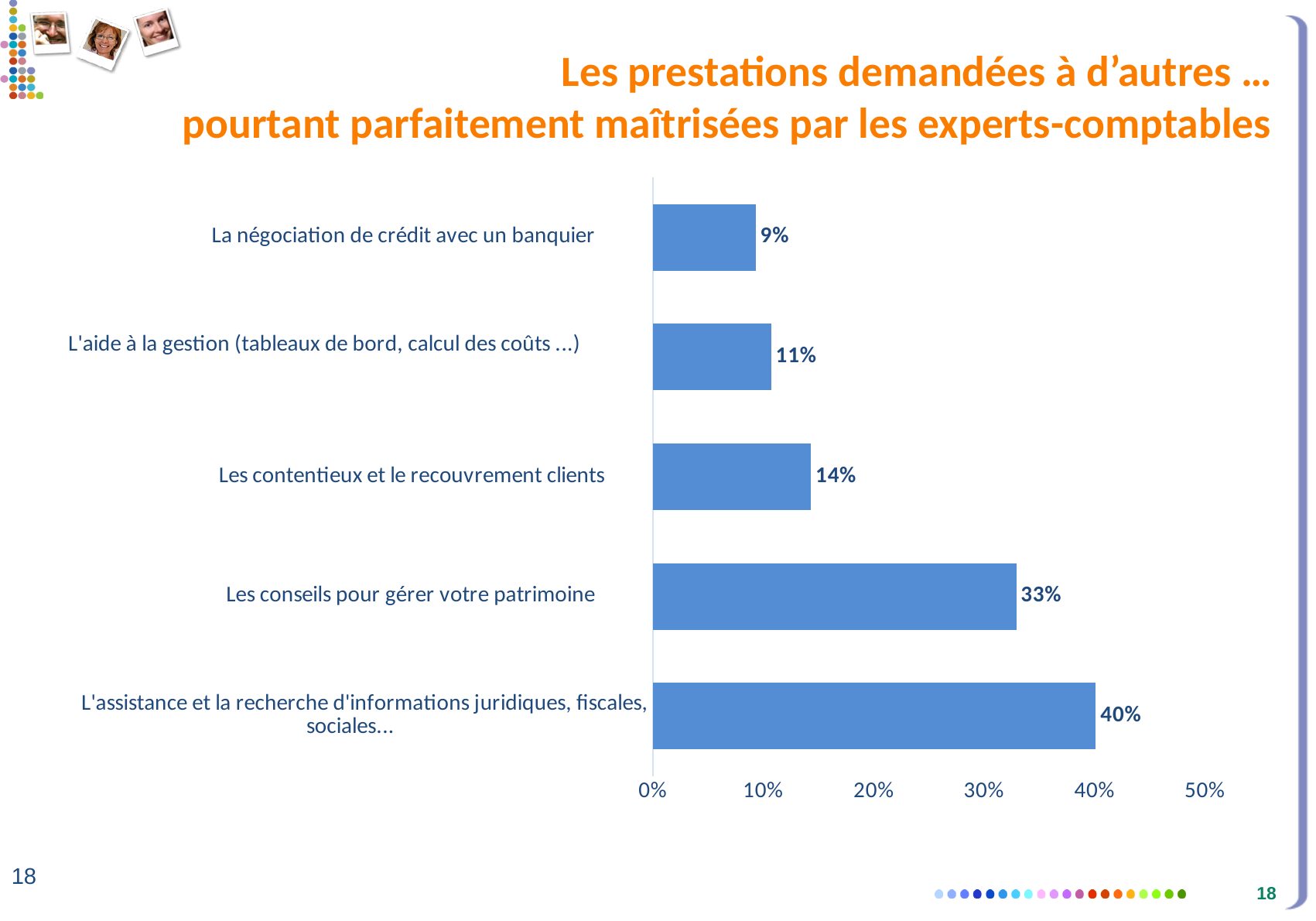
How many categories are shown in the chart? 5 What is the highest value shown on the x axis? 50% What is the difference between the values for "L'assistance et la recherche d'informations juridiques, fiscales, sociales…" and "Les conseils pour gérer votre patrimoine"? 7% What is the value for "Les contentieux et le recouvrement clients"? 14% What is the difference between the values for "Les contentieux et le recouvrement clients" and "L'aide à la gestion (tableaux de bord, calcul des coûts …)"? 3% What kind of chart is shown on the slide? bar chart Is the value for "Les conseils pour gérer votre patrimoine" greater or less than 30%? greater Which category has the lowest value? La négociation de crédit avec un banquier What is the value for "Les conseils pour gérer votre patrimoine"? 33% What is the value for "La négociation de crédit avec un banquier"? 9% Which category has the highest value? L'assistance et la recherche d'informations juridiques, fiscales, sociales… Which is larger: the value for "L'aide à la gestion (tableaux de bord, calcul des coûts …)" or the value for "Les contentieux et le recouvrement clients"? Les contentieux et le recouvrement clients